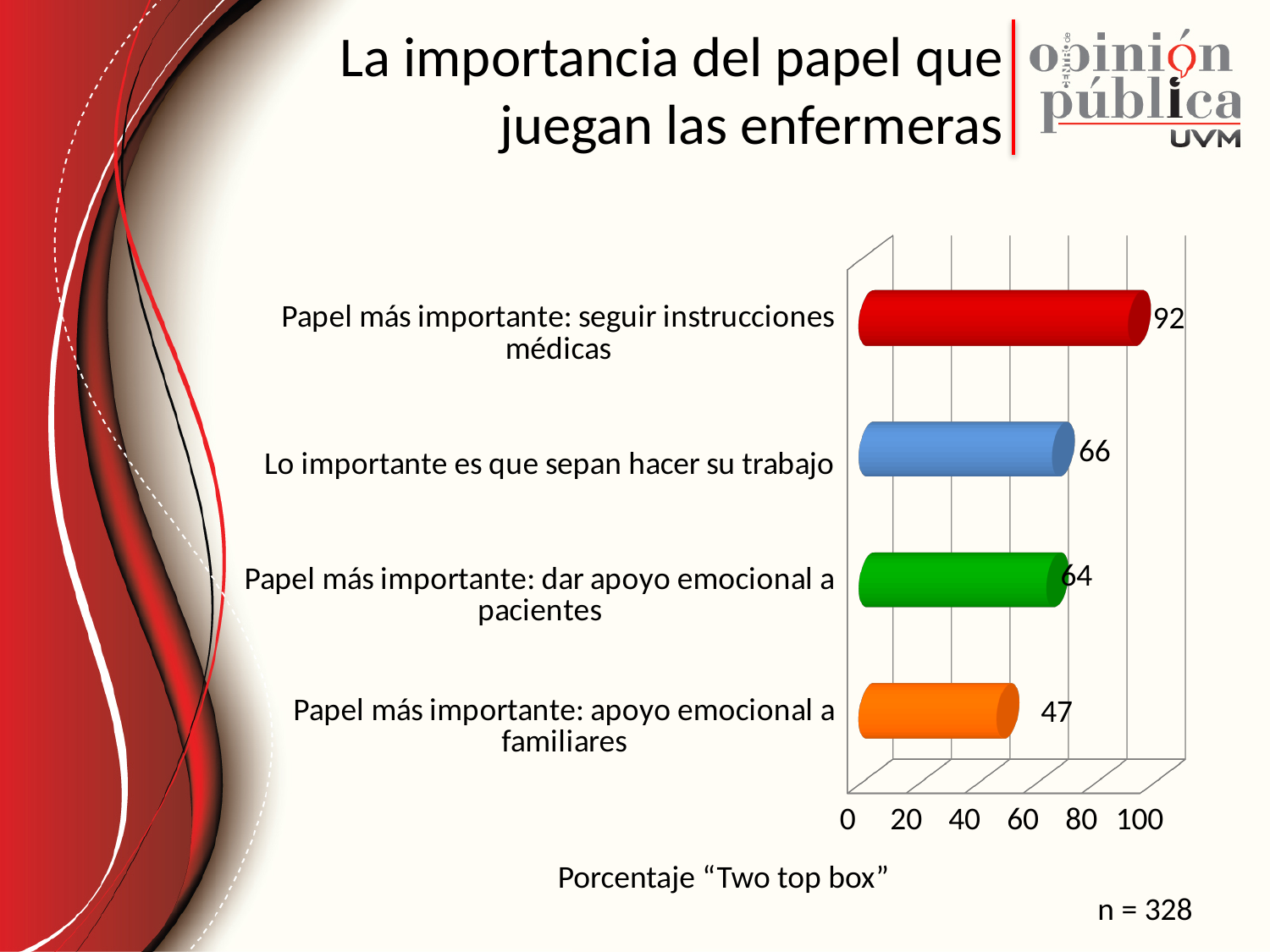
What is the value for "Papel más importante: dar apoyo emocional a pacientes"? 64 Which category has the highest value? Papel más importante: seguir instrucciones médicas What is the value for "Lo importante es que sepan hacer su trabajo"? 66 What kind of chart is shown on the slide? Bar chart Which is larger: the value for "Papel más importante: seguir instrucciones médicas" or the value for "Lo importante es que sepan hacer su trabajo"? Papel más importante: seguir instrucciones médicas What is the difference between the values for "Lo importante es que sepan hacer su trabajo" and "Papel más importante: dar apoyo emocional a pacientes"? 2 What is the label of the horizontal axis of the chart? Porcentaje "Two top box" What is the value for "Papel más importante: apoyo emocional a familiares"? 47 Which category has the lowest value? Papel más importante: apoyo emocional a familiares What is the value for "Papel más importante: seguir instrucciones médicas"? 92 What is the difference between the values for "Papel más importante: seguir instrucciones médicas" and "Papel más importante: apoyo emocional a familiares"? 45 How many categories are shown in the chart? 4